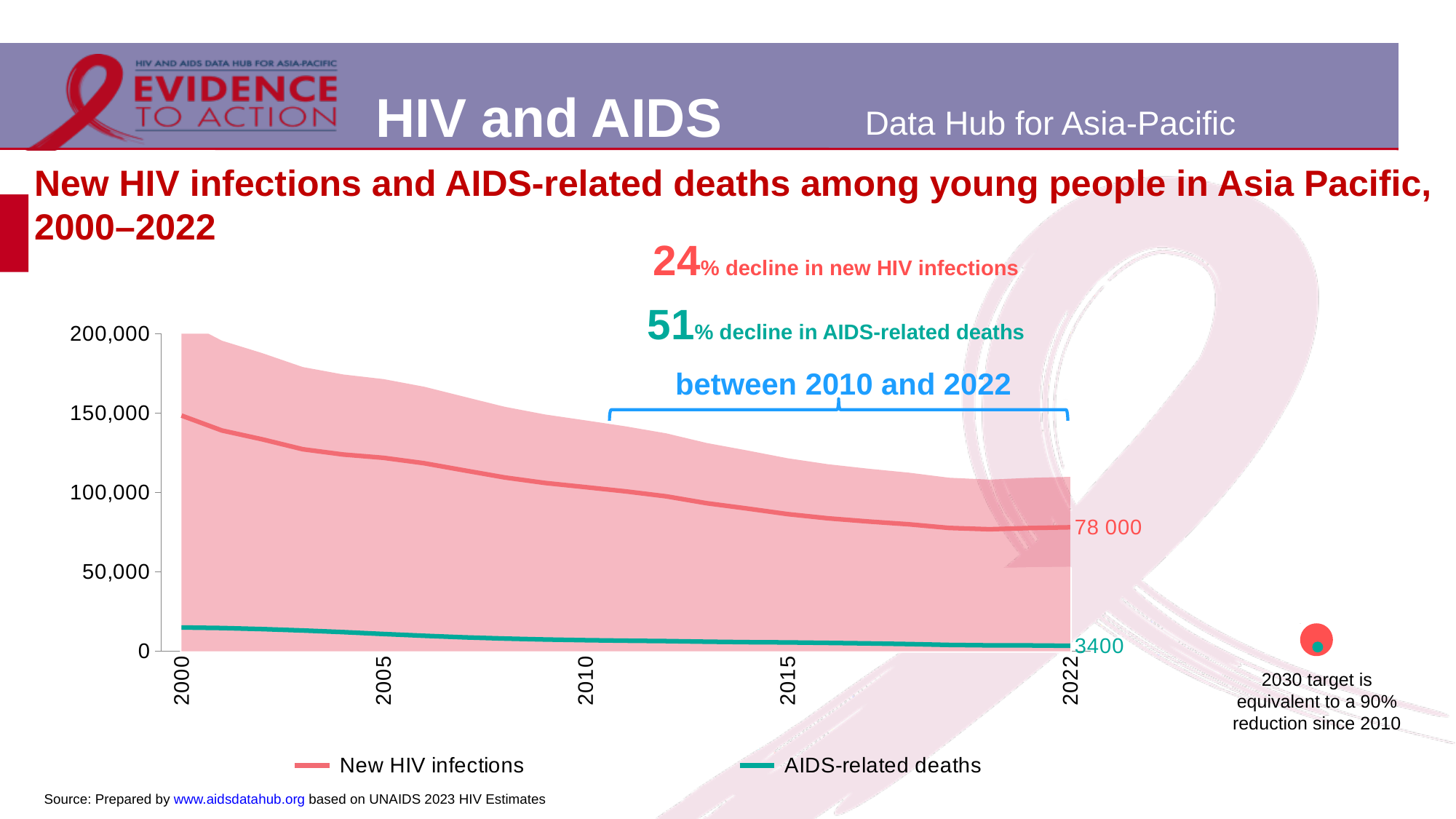
What is the difference between New HIV infections and AIDS-related deaths in 2022? 74 600 Is the value for New HIV infections in 2000 greater or less than 100,000? greater According to the annotation on the chart, what was the percentage decline in AIDS-related deaths between 2010 and 2022? 51% Is the value for New HIV infections in 2010 greater or less than 150,000? less What is the value for New HIV infections in 2022? 78 000 What is the value for AIDS-related deaths in 2022? 3400 What kind of chart is shown on the slide? Area and line chart Do New HIV infections rise or fall from 2000 to 2022? Fall Do AIDS-related deaths rise or fall from 2000 to 2022? Fall In 2022, which series has the higher value, New HIV infections or AIDS-related deaths? New HIV infections How many series does the legend list? 2 Is the value for AIDS-related deaths in 2000 greater or less than 50,000? less